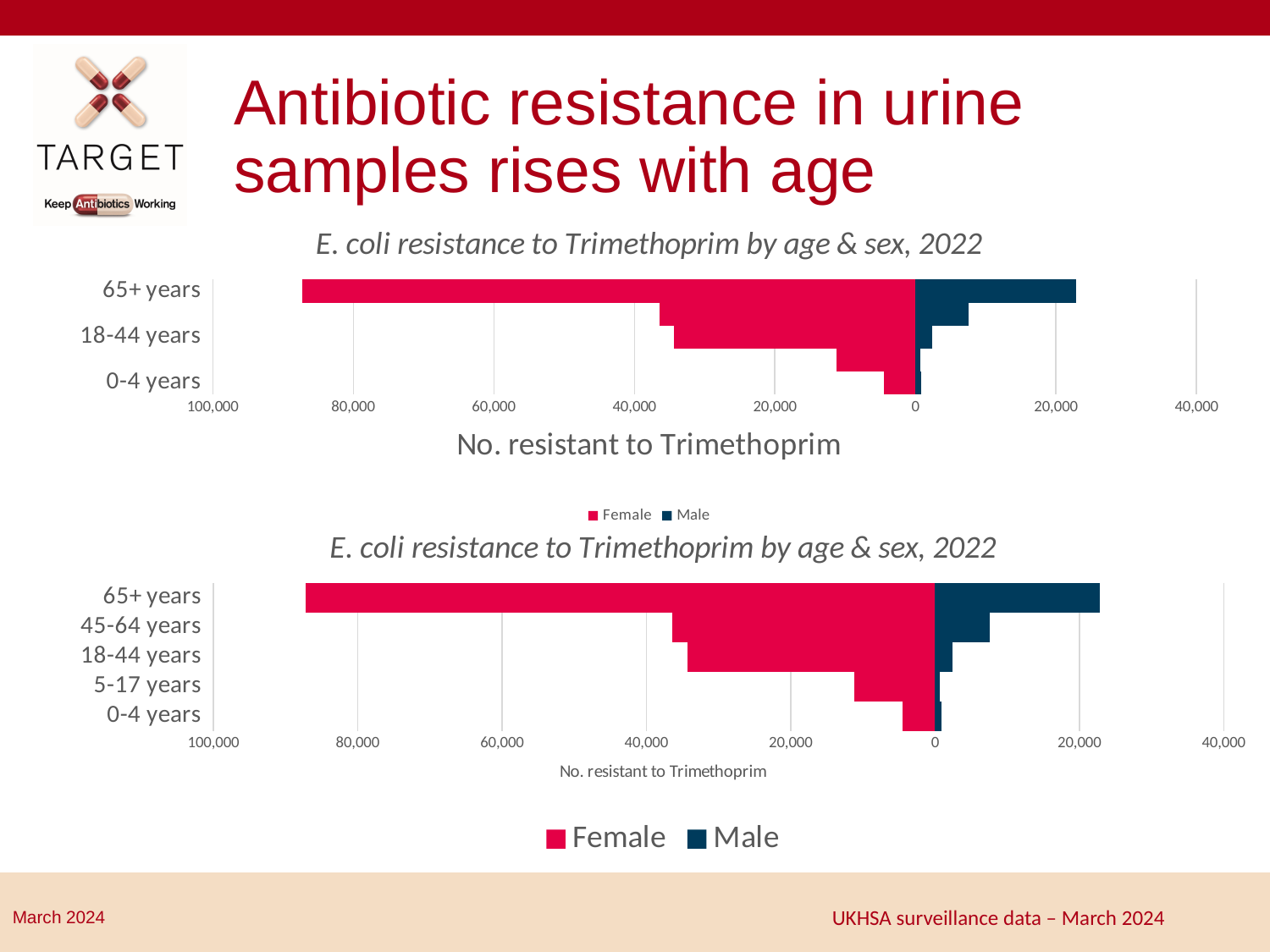
In the bottom chart, which colour represents the Male series? dark blue In the bottom chart, how many age categories are shown on the vertical axis? 5 In the bottom chart, is the Female value for 65+ years greater or less than 80,000? greater In the bottom chart, which age group has the highest number of Female samples resistant to Trimethoprim? 65+ years In the bottom chart, do the Female values rise or fall as age increases from 0-4 years to 65+ years? rise In the top chart, which is larger for 65+ years: the Female value or the Male value? Female What kind of chart is the bottom chart on the slide? bar chart In the top chart, is the Female value for 0-4 years greater or less than 20,000? less What is the title of the top chart? E. coli resistance to Trimethoprim by age & sex, 2022 In the bottom chart, which age group has the lowest number of Male samples resistant to Trimethoprim? 5-17 years In the bottom chart, how many series does the legend list? 2 In the bottom chart, is the Male value for 65+ years greater or less than 20,000? greater